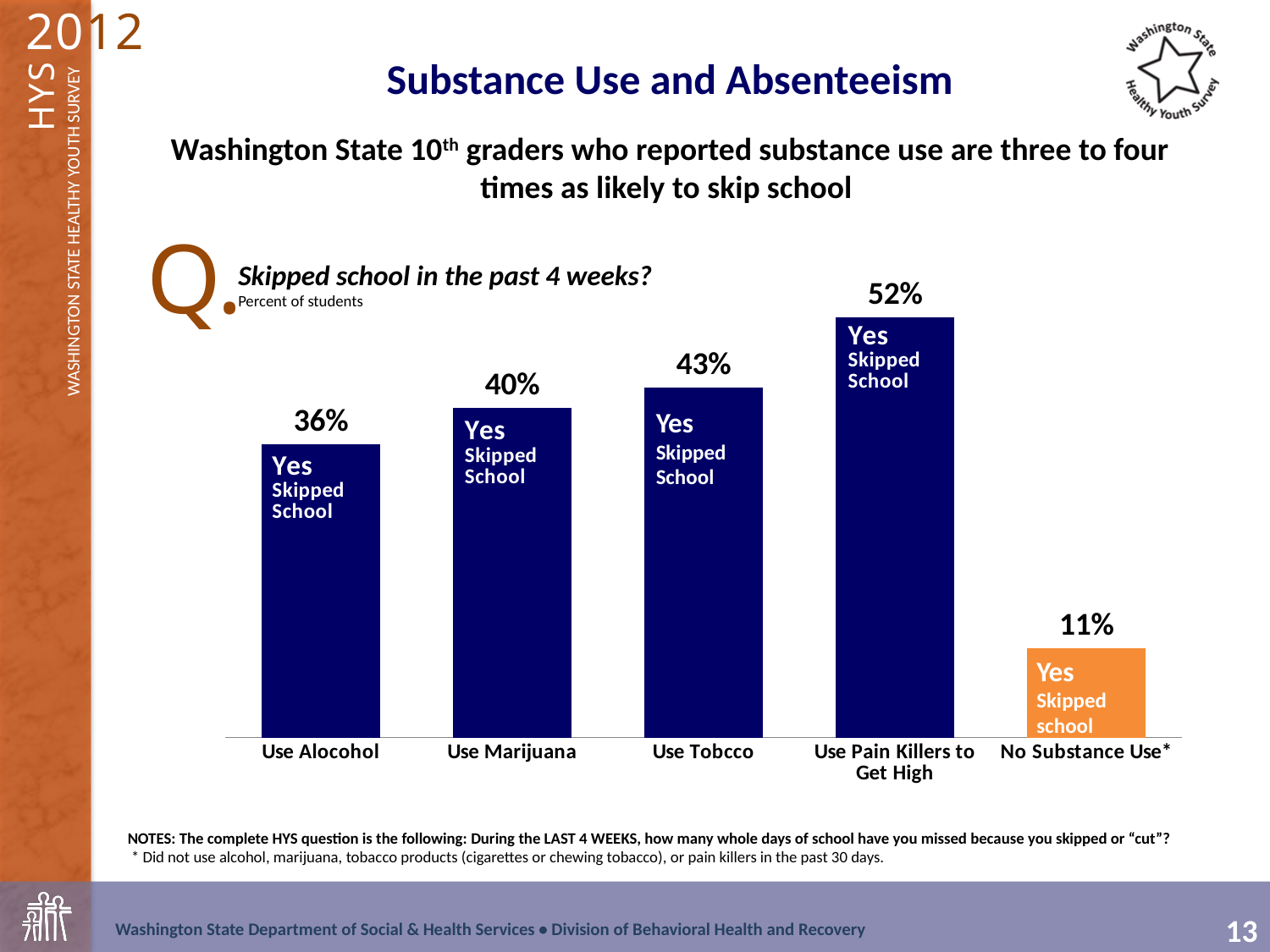
Which is larger, the value for 'Use Alocohol' or the value for 'Use Tobcco'? Use Tobcco What is the difference between the 'Use Tobcco' value and the 'Use Marijuana' value? 3% Which category has the lowest percentage of students who skipped school? No Substance Use* What is the difference between the 'Use Pain Killers to Get High' value and the 'No Substance Use*' value? 41% Do the values rise or fall from 'Use Alocohol' to 'Use Pain Killers to Get High'? Rise Which category has the highest percentage of students who skipped school? Use Pain Killers to Get High How many categories are shown on the x axis of the chart? 5 Which bar is coloured orange rather than dark blue? No Substance Use* What percentage of students who use alcohol reported skipping school in the past 4 weeks? 36% What is the value shown for the 'Use Pain Killers to Get High' bar? 52% What percentage is shown for the 'No Substance Use*' category? 11% What kind of chart is shown on the slide? Bar chart